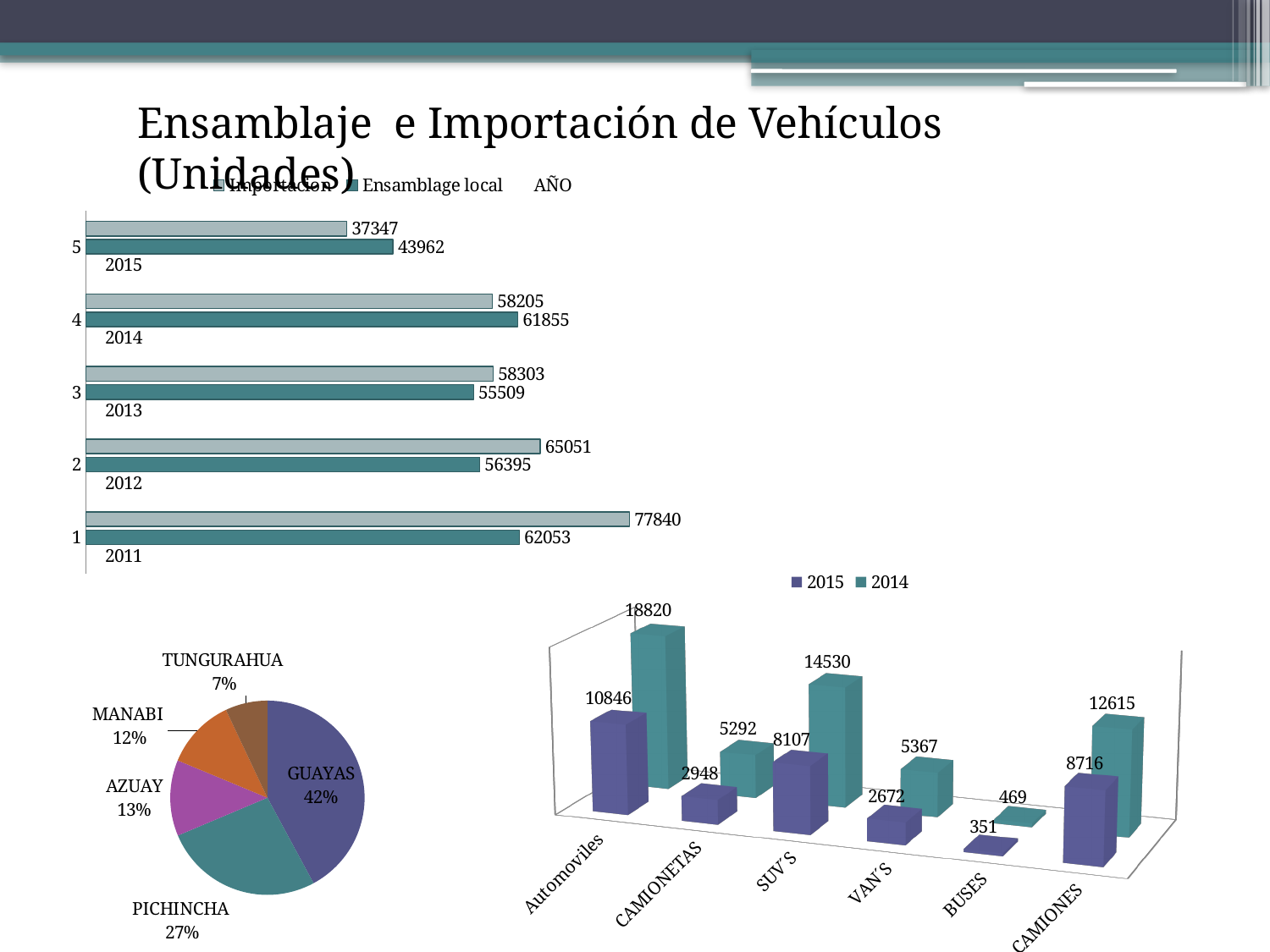
In the top bar chart, which is larger in 2014: Importación or Ensamblage local? Ensamblage local In the pie chart, what share does GUAYAS have? 42% In the bottom-right chart, which category has the lowest 2015 value? BUSES In the pie chart, which province has the smallest slice? TUNGURAHUA In the top bar chart, what is the difference between Importación and Ensamblage local in 2012? 8656 In the top bar chart, how many years are shown? 5 In the bottom-right chart, what is the 2014 value for SUV'S? 14530 In the bottom-right chart, what is the difference between the 2014 and 2015 values for Automoviles? 7974 In the top bar chart, what is the Ensamblage local value for 2015? 43962 In the bottom-right chart, how many series does the legend list? 2 In the top bar chart, which year has the highest Importación value? 2011 In the top bar chart, what is the Importación value for 2011? 77840